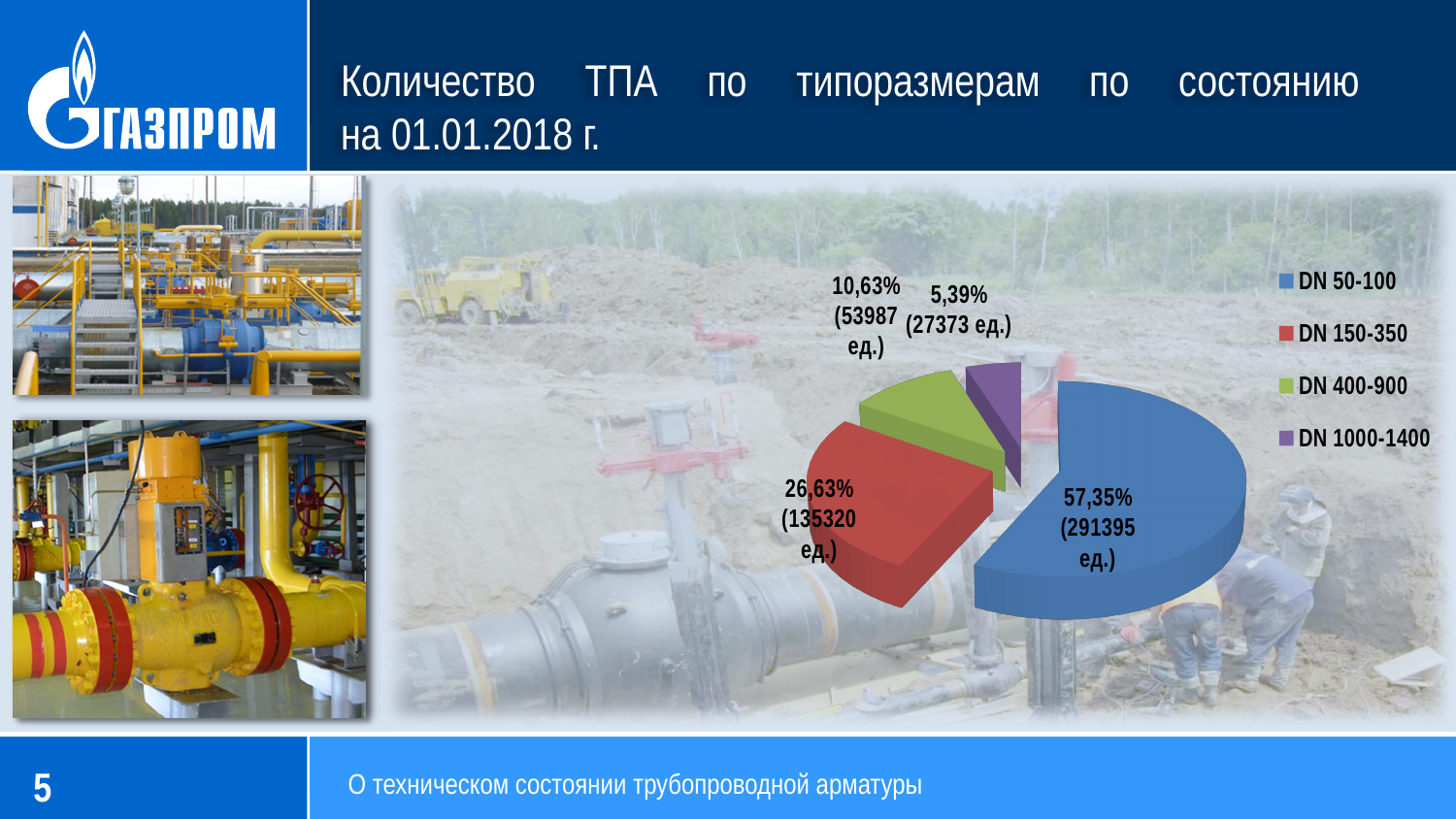
What is the difference in percentage points between the DN 50-100 and DN 150-350 shares? 30,72% Which colour represents DN 400-900 in the pie chart? green What kind of chart is shown on the slide? pie chart How many entries does the legend of the pie chart list? 4 Which category has the largest share of the pie? DN 50-100 Which has more units, DN 150-350 or DN 400-900? DN 150-350 How many slices does the pie chart have? 4 What percentage share does the DN 50-100 slice have? 57,35% What is the number of units (ед.) for DN 150-350? 135320 ед. What is the number of units (ед.) for DN 1000-1400? 27373 ед. Which category has the smallest share of the pie? DN 1000-1400 What percentage share does the DN 400-900 slice have? 10,63%